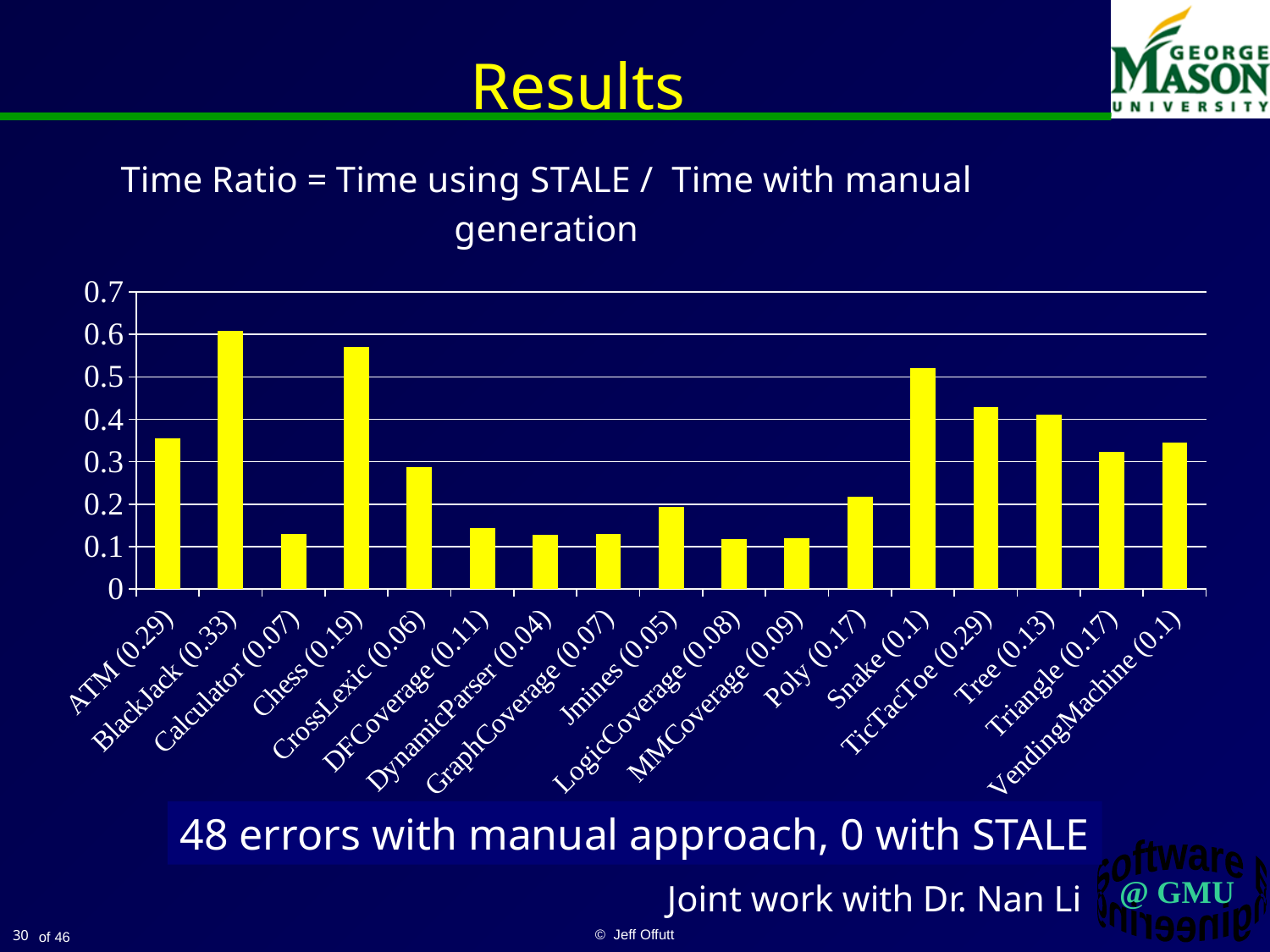
Is the value for Snake (0.1) greater or less than 0.4? greater What is the title of the chart? Time Ratio = Time using STALE / Time with manual generation Is the value for Poly (0.17) greater or less than 0.3? less Is the value for ATM (0.29) greater or less than 0.3? greater How many categories (programs) are plotted on the x axis of the chart? 17 Which has the larger value, Snake (0.1) or TicTacToe (0.29)? Snake (0.1) Which has the larger value, ATM (0.29) or Calculator (0.07)? ATM (0.29) Which category has the highest bar in the chart? BlackJack (0.33) What kind of chart is shown on the slide? bar chart